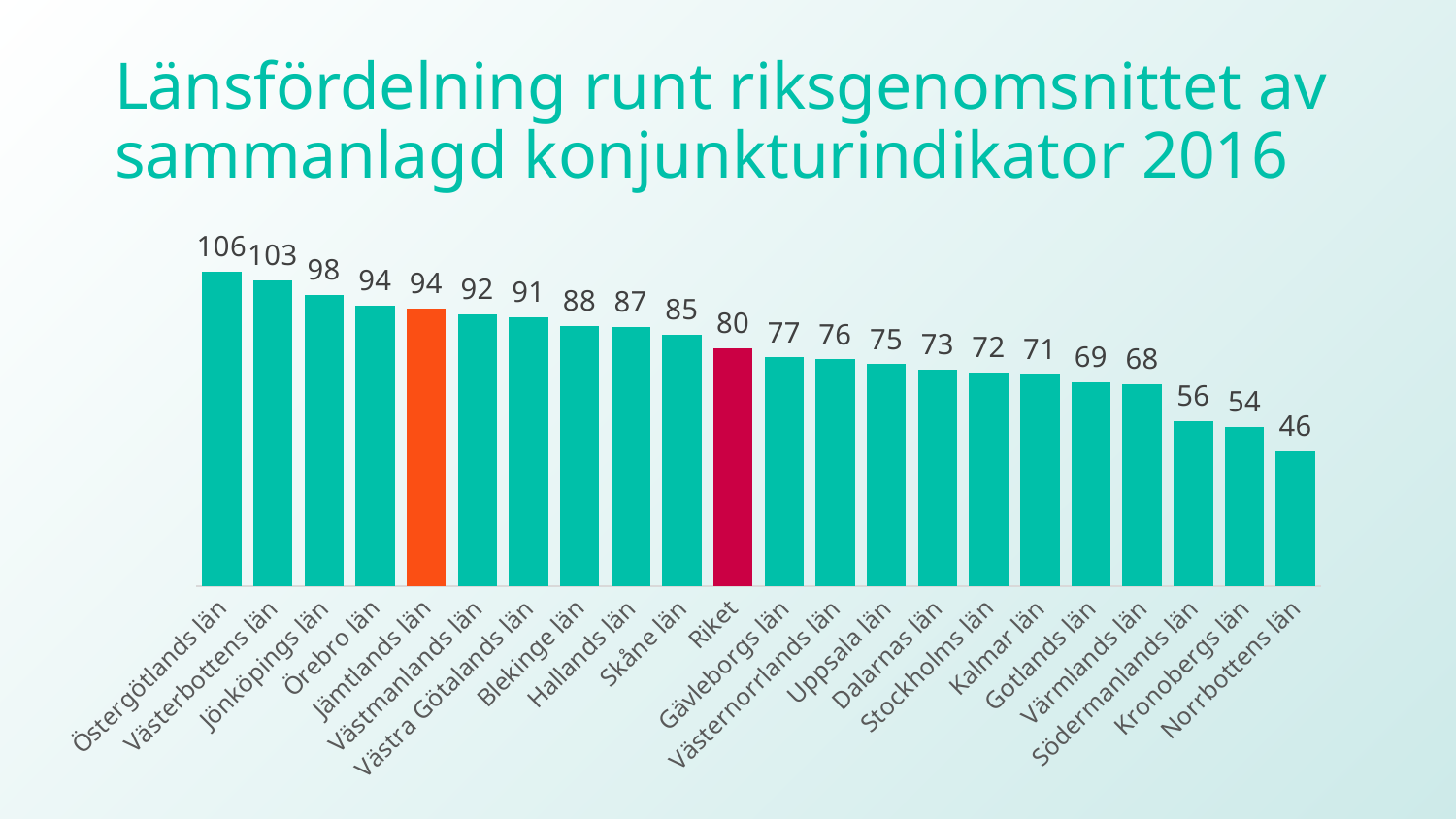
How many bars are shown in the chart? 22 Do the values rise or fall from left to right along the x axis? Fall What is the difference between the values for Östergötlands län and Norrbottens län? 60 Which bar is coloured orange? Jämtlands län What is the value for Stockholms län? 72 Which category has the highest value? Östergötlands län Which is larger, the value for Uppsala län or the value for Gotlands län? Uppsala län What is the difference between the values for Skåne län and Riket? 5 What is the value for Jämtlands län? 94 What kind of chart is shown on the slide? Bar chart Which category has the lowest value? Norrbottens län What is the value for Riket? 80